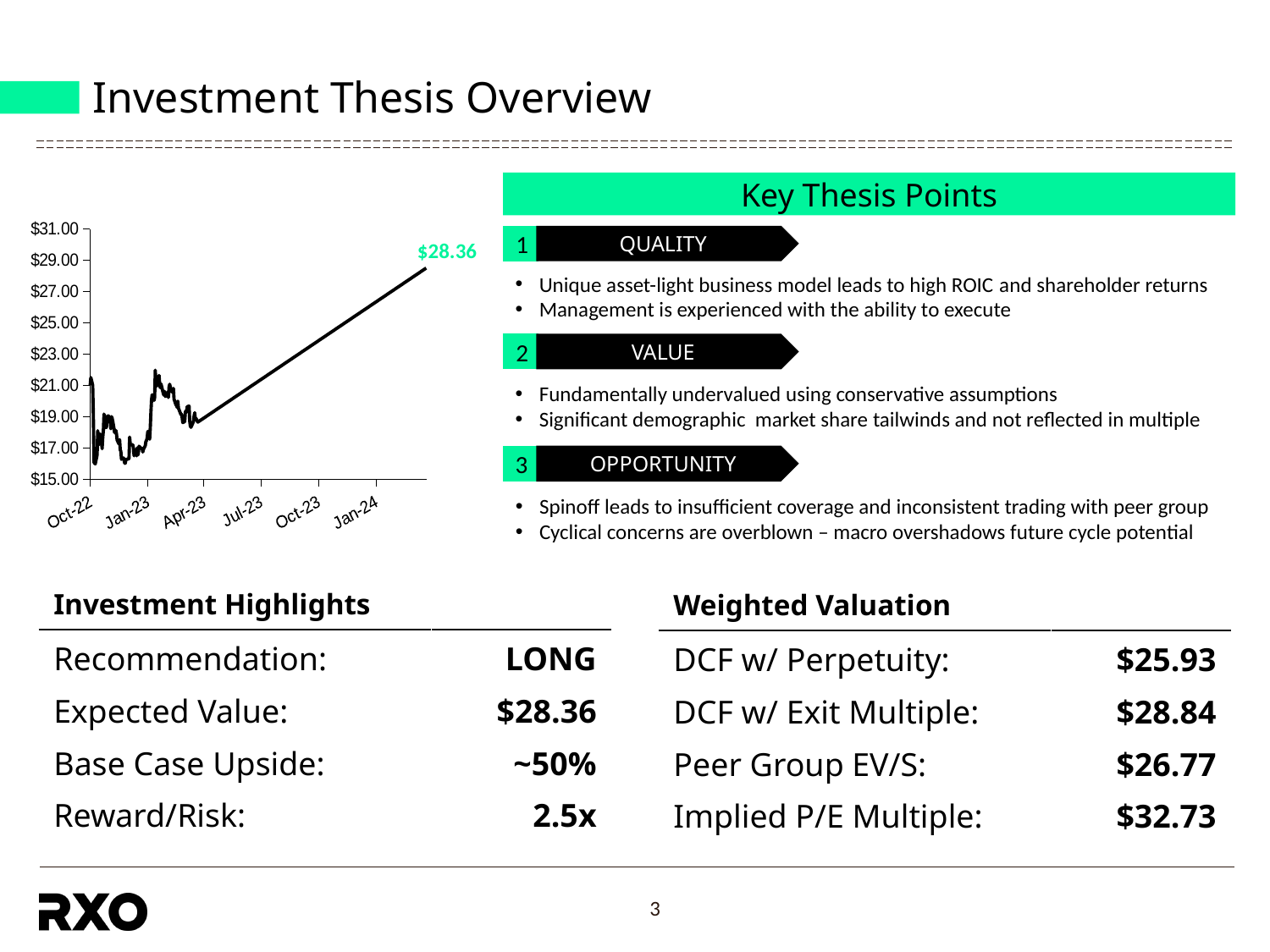
Is the value of the line around Apr-23 greater or less than $23.00? less Is the value at the end of the line (Jan-24) greater or less than $27.00? greater Does the line rise or fall between Apr-23 and Jan-24? rise What value is printed as the data label at the end of the line in the chart? $28.36 What is the highest tick value shown on the y axis of the chart? $31.00 Which x-axis label comes first on the chart? Oct-22 What is the lowest tick value shown on the y axis of the chart? $15.00 Does the line overall rise or fall from Oct-22 to Jan-24? rise How many date labels are shown on the x axis of the chart? 6 Is the value of the line at the start (Oct-22) greater or less than $25.00? less What kind of chart is shown on the left of the slide? line chart